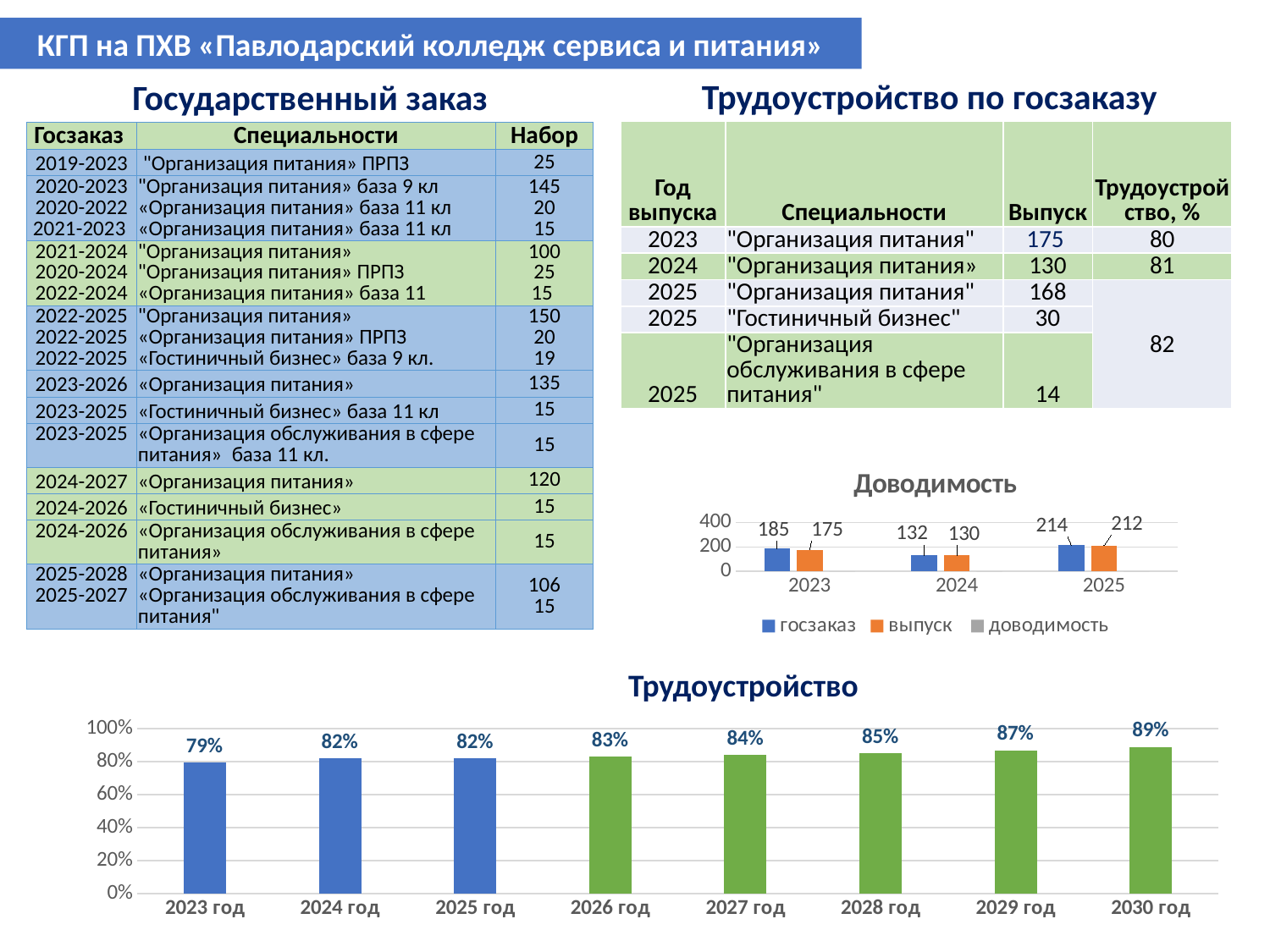
In the "Доводимость" chart, how many series does the legend list? 3 In the "Доводимость" chart, what is the выпуск value for 2024? 130 In the "Трудоустройство" chart, how many years are shown on the x axis? 8 In the "Трудоустройство" chart, do the values rise or fall from 2023 год to 2030 год? rise In the "Доводимость" chart, which year has the lowest госзаказ value? 2024 In the "Доводимость" chart, what is the госзаказ value for 2025? 214 In the "Трудоустройство" chart, what is the value for 2023 год? 79% In the "Трудоустройство" chart, which year has the lowest value? 2023 год In the "Трудоустройство" chart, which year has the highest value? 2030 год In the "Трудоустройство" chart, what is the value for 2030 год? 89% In the "Трудоустройство" chart, what is the difference between the values for 2030 год and 2023 год? 10% What kind of chart is the "Доводимость" chart? bar chart